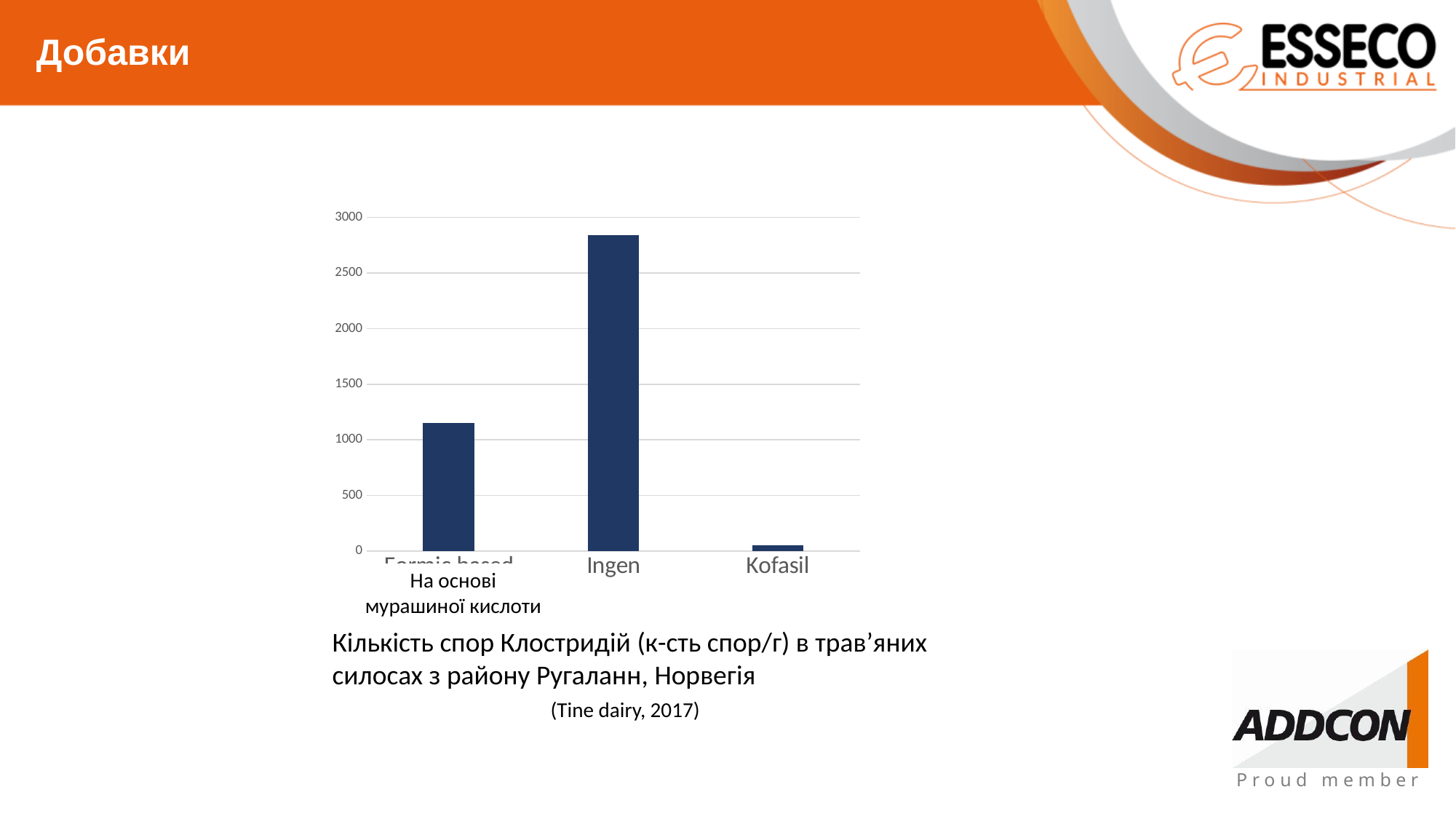
What is the highest value shown on the vertical axis? 3000 Is the value for Ingen greater or less than 2500? greater Which category has the highest value? Ingen What source is cited below the chart? (Tine dairy, 2017) How many categories are plotted on the chart? 3 What kind of chart is shown on the slide? bar chart Which is larger, the value for Ingen or the value for Kofasil? Ingen Is the value for На основі мурашиної кислоти greater or less than 1500? less Is the value for Kofasil greater or less than 500? less Which category has the lowest value? Kofasil Which is larger, the value for На основі мурашиної кислоти or the value for Ingen? Ingen